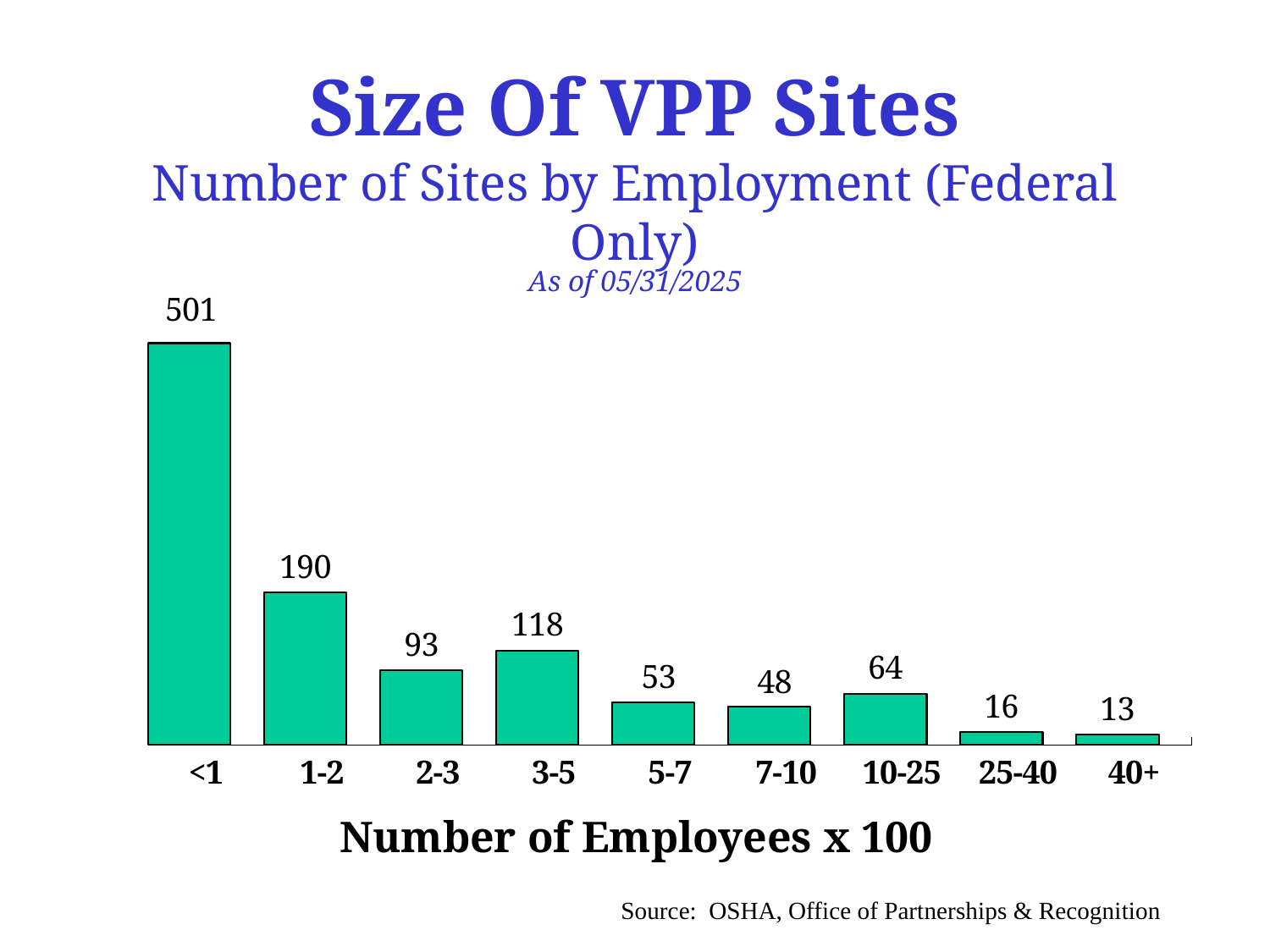
Which employee-size category has the lowest number of sites? 40+ What is the x-axis label of the chart? Number of Employees x 100 What is the number of sites for the 3-5 employee-size category? 118 Which has more sites, the 2-3 category or the 3-5 category? 3-5 What is the difference between the number of sites in the <1 category and the 1-2 category? 311 What kind of chart is shown on the slide? Bar chart Which employee-size category has the highest number of sites? <1 What is the difference between the values for the 3-5 and 2-3 categories? 25 What is the value shown for the 10-25 category? 64 How many sites are in the <1 category (Number of Employees x 100)? 501 Which has more sites, the 5-7 category or the 7-10 category? 5-7 How many employee-size categories are shown on the x axis? 9